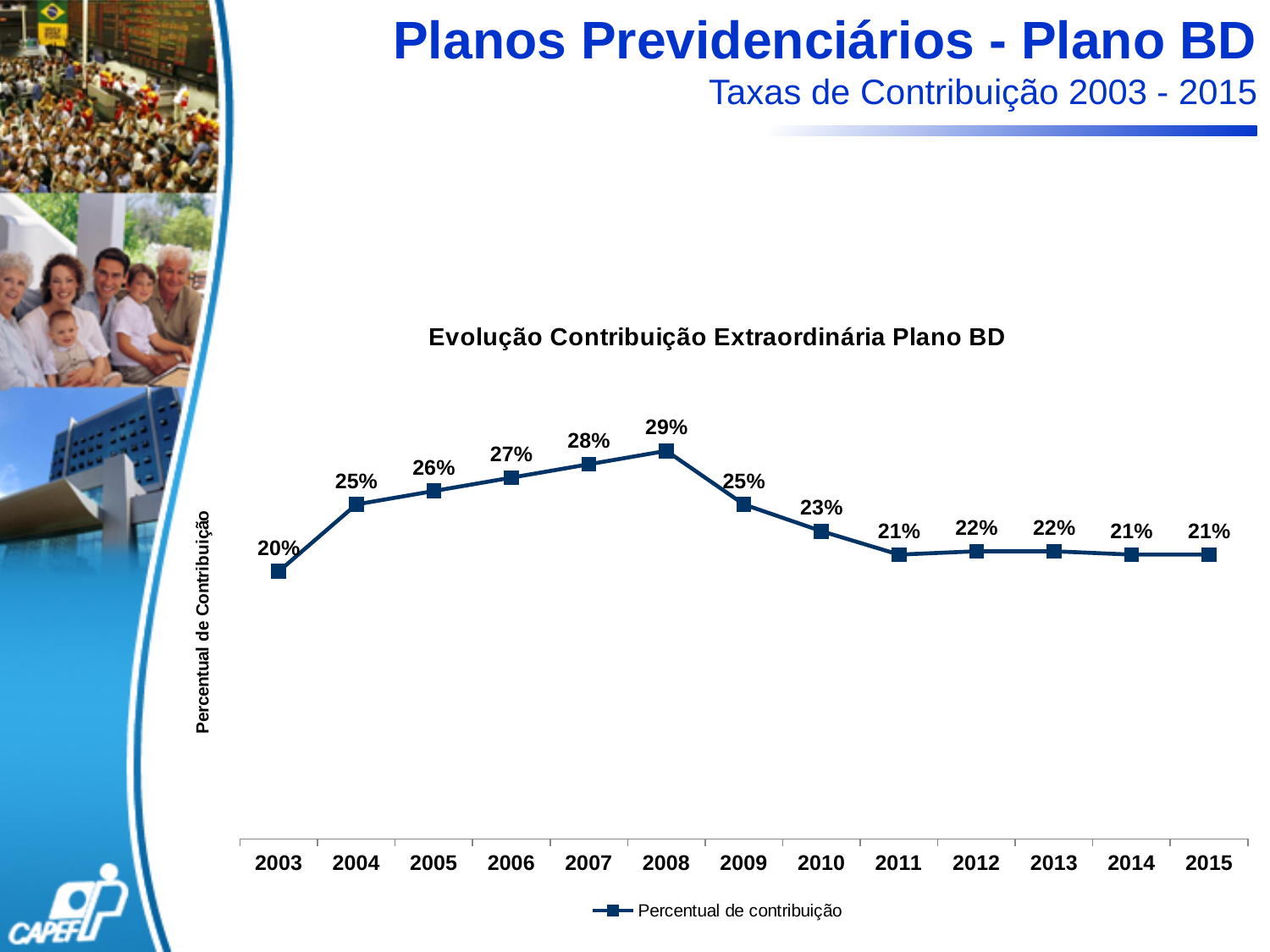
How many series does the legend list? 1 Which is larger, the value for 2009 or the value for 2012? 2009 Which year has the highest value? 2008 Do the values rise or fall from 2003 to 2008? rise Which year has the lowest value? 2003 How many years are plotted on the x axis? 13 What is the value for 2003? 20% What is the title of the chart? Evolução Contribuição Extraordinária Plano BD What is the value for 2010? 23% What is the difference between the values for 2008 and 2003? 9% What is the value for 2008? 29% What kind of chart is shown? line chart